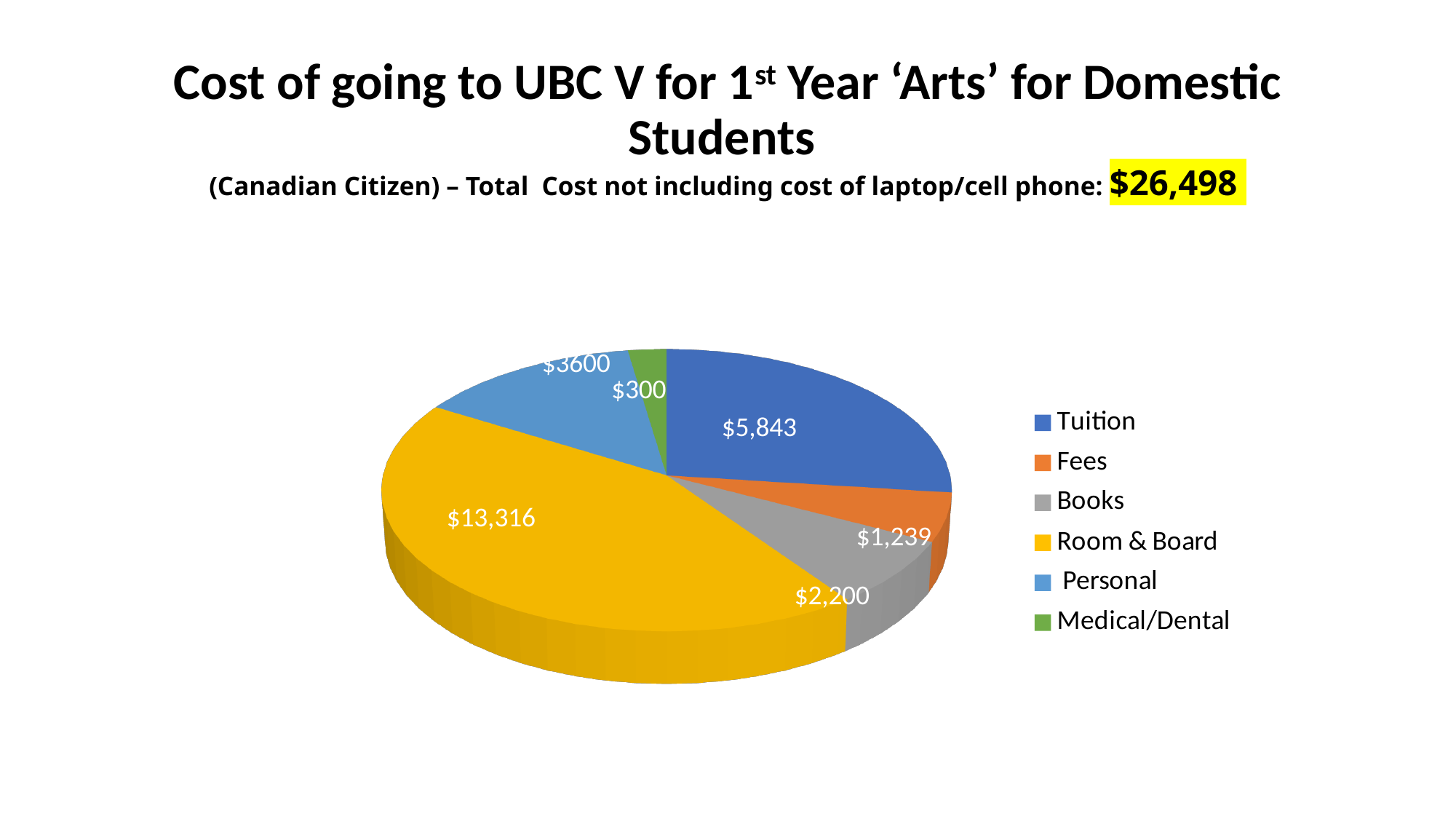
Which is larger, the Personal value or the Books value? Personal How many categories does the pie chart have? 6 What is the value of the Medical/Dental slice? $300 What is the value of the Tuition slice? $5,843 What is the total of all the slices in the pie chart? $26,498 Which category has the smallest slice of the pie? Medical/Dental What type of chart is shown on the slide? Pie chart What is the value of the Room & Board slice? $13,316 What is the value of the Books slice? $2,200 What is the difference between the Room & Board value and the Tuition value? $7,473 What is the value of the Fees slice? $1,239 Which category has the largest slice of the pie? Room & Board